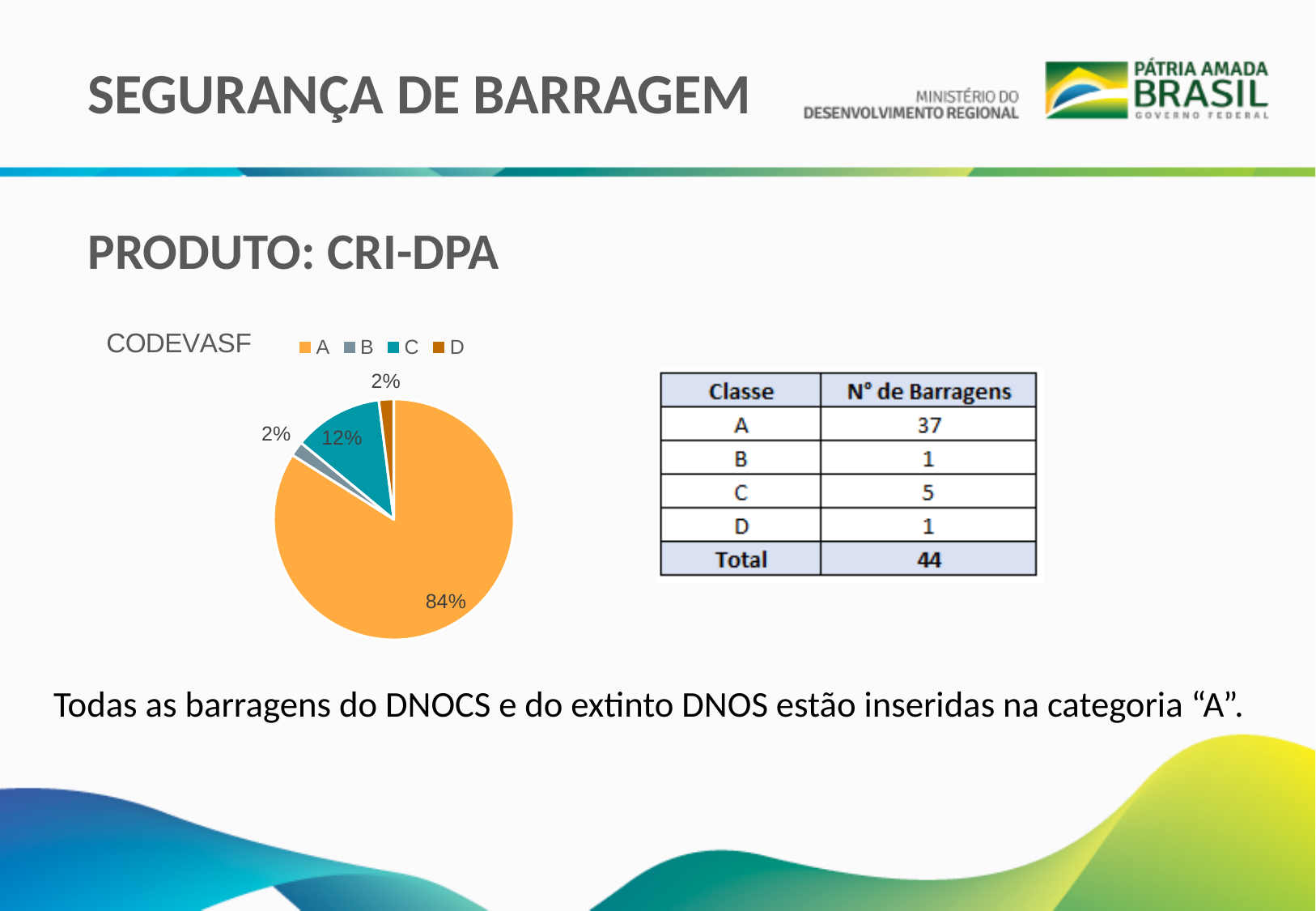
What is the title of the pie chart? CODEVASF Which category has the largest slice in the pie chart? A What type of chart is shown on the slide? pie chart How many categories does the legend of the pie chart list? 4 How many slices does the pie chart have? 4 What share of the pie chart does category A represent? 84% What share of the pie chart does category C represent? 12% What share of the pie chart does category D represent? 2% Which is larger in the pie chart, the slice for A or the slice for C? A What colour is the slice for category A in the pie chart? orange What is the difference in percentage points between the slices for A and C in the pie chart? 72